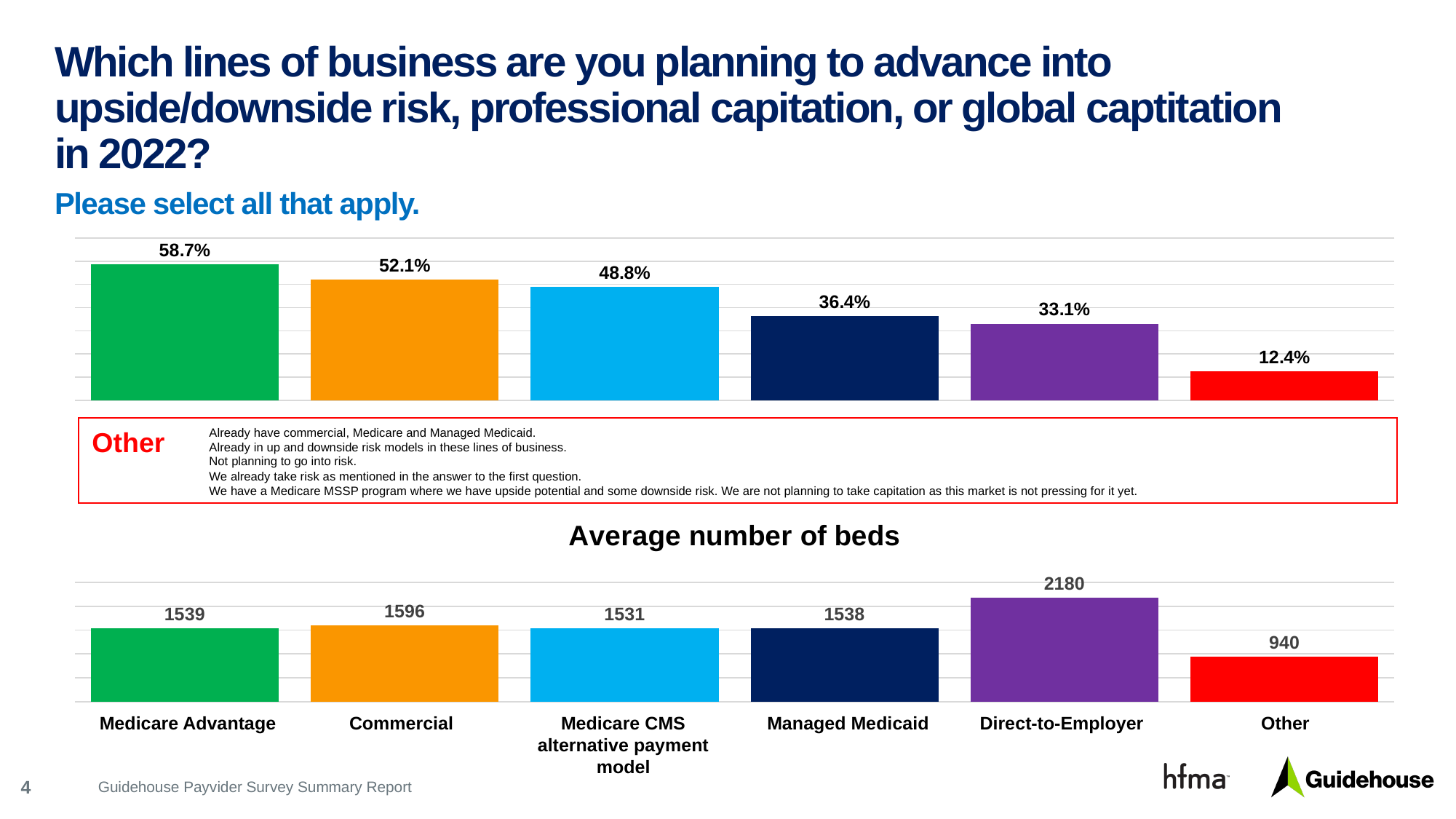
How many categories are shown in the 'Average number of beds' chart? 6 In the 'Average number of beds' chart, which category has the highest value? Direct-to-Employer In the top chart, what is the difference between the percentages for Commercial and Managed Medicaid? 15.7% In the 'Average number of beds' chart, what is the value for Other? 940 In the top chart, which category has the lowest percentage? Other In the top chart, do the values rise or fall from left to right across the categories? Fall In the top chart, what percentage is shown for Direct-to-Employer? 33.1% In the top chart, which is larger: the value for Medicare CMS alternative payment model or the value for Managed Medicaid? Medicare CMS alternative payment model In the 'Average number of beds' chart, what is the value for Commercial? 1596 In the 'Average number of beds' chart, what is the difference between Direct-to-Employer and Medicare Advantage? 641 What type of chart is the 'Average number of beds' chart? Bar chart In the top chart, what percentage is shown for Medicare Advantage? 58.7%